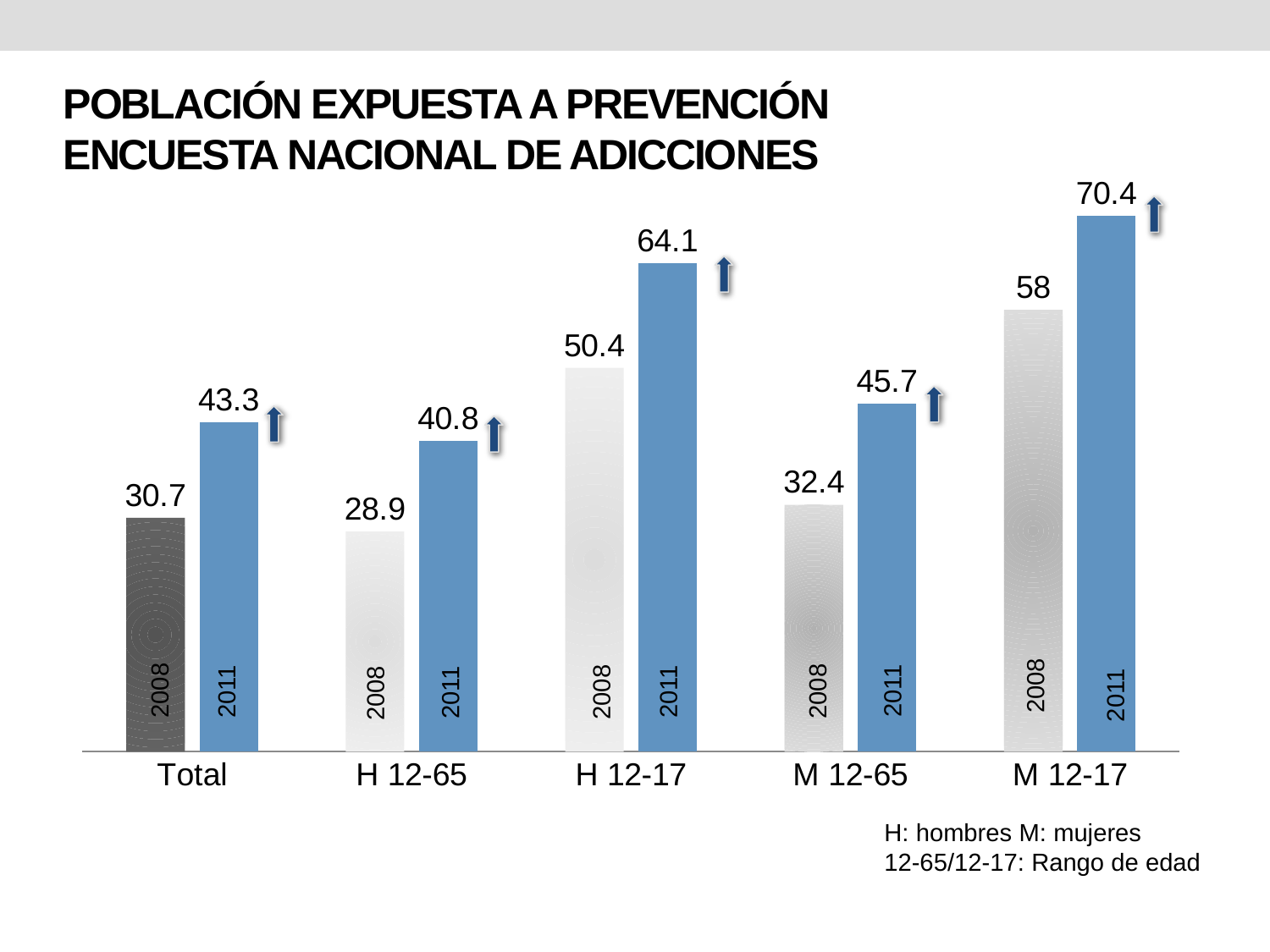
What is the 2011 value for Total? 43.3 What kind of chart is shown on the slide? Bar chart What is the difference between the 2011 and 2008 values for Total? 12.6 Which is larger, the 2008 value for M 12-65 or the 2008 value for H 12-65? M 12-65 How many categories are shown on the x axis? 5 What is the 2008 value for H 12-17? 50.4 What is the 2011 value for M 12-65? 45.7 How many series (years) are plotted for each category? 2 Which category has the highest 2011 value? M 12-17 What is the 2008 value for M 12-17? 58 Which category has the lowest 2008 value? H 12-65 What is the difference between the 2011 and 2008 values for H 12-17? 13.7